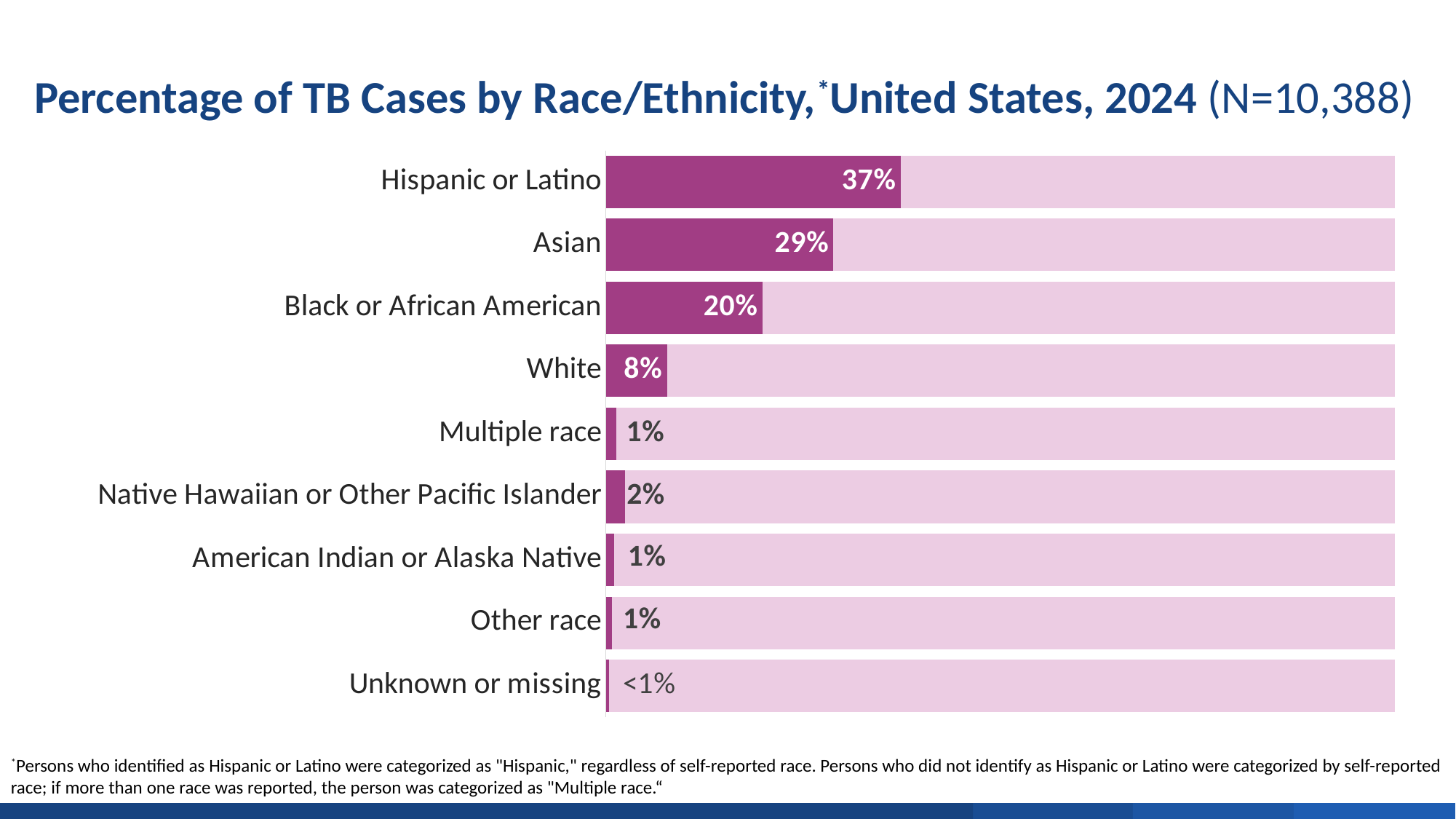
Which is larger, the percentage for Asian or for Black or African American? Asian What value is shown for Unknown or missing? <1% What percentage of TB cases were among White persons? 8% What value is shown for Native Hawaiian or Other Pacific Islander? 2% What is the difference in percentage points between Black or African American and White? 12 What percentage of TB cases were among Asian persons? 29% What percentage of TB cases were among Black or African American persons? 20% What is the difference in percentage points between Hispanic or Latino and Asian? 8 What type of chart is shown on the slide? Bar chart How many race/ethnicity categories are shown in the chart? 9 What percentage of TB cases were among Hispanic or Latino persons? 37% Which race/ethnicity category has the highest percentage of TB cases? Hispanic or Latino